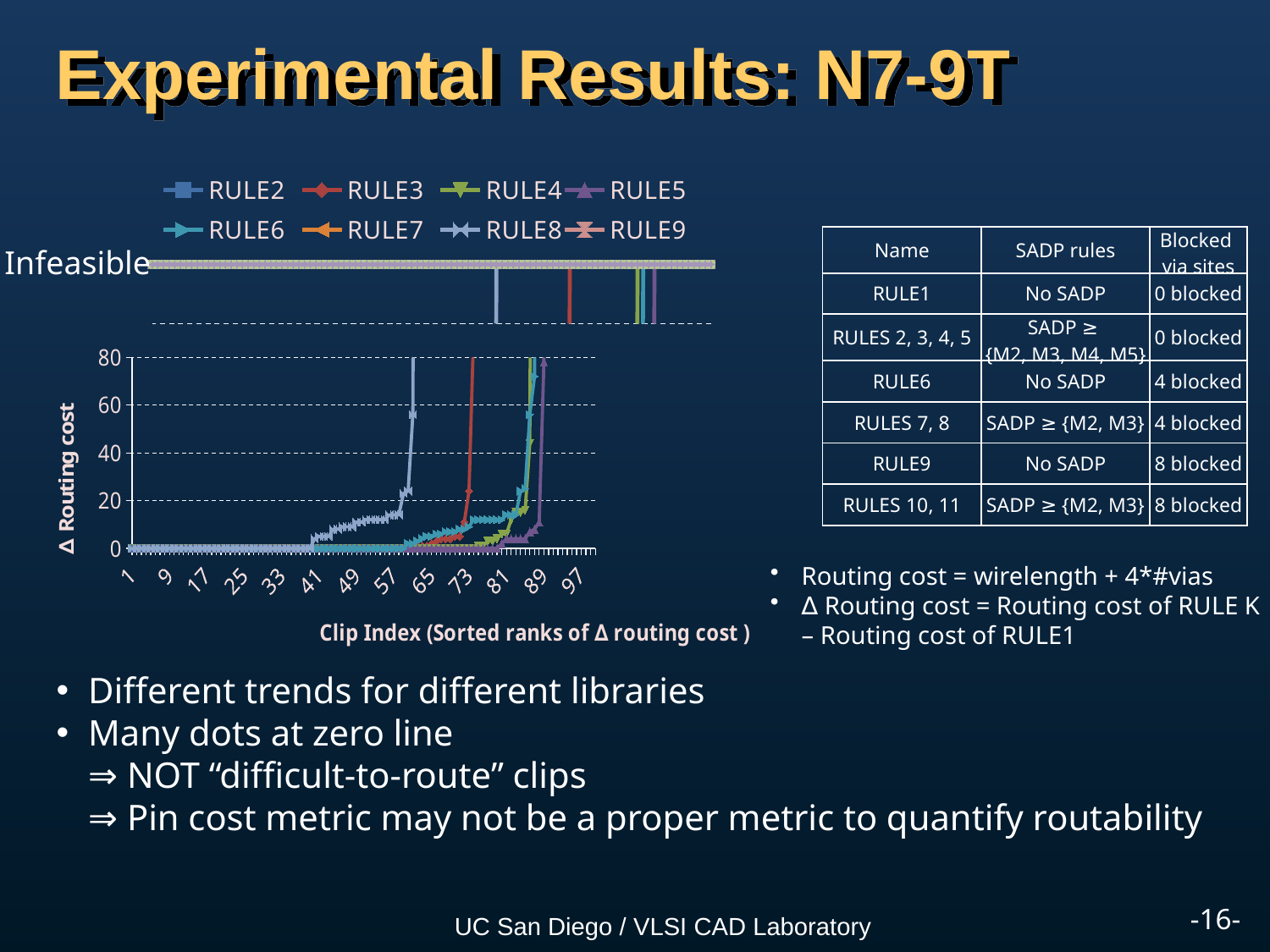
How many series does the chart legend list? 8 Which series is listed first in the chart legend? RULE2 What is the first tick label shown on the x axis of the chart? 1 Which series is listed last in the chart legend? RULE9 What kind of chart is shown on the slide? line chart What is the label of the y axis of the chart? Δ Routing cost What is the highest numeric tick shown on the y axis of the chart? 80 Do the plotted Δ routing cost values rise or fall as the clip index increases along the x axis? rise What is the label of the x axis of the chart? Clip Index (Sorted ranks of Δ routing cost ) How many tick labels are shown along the x axis of the chart? 13 What is the last tick label shown on the x axis of the chart? 97